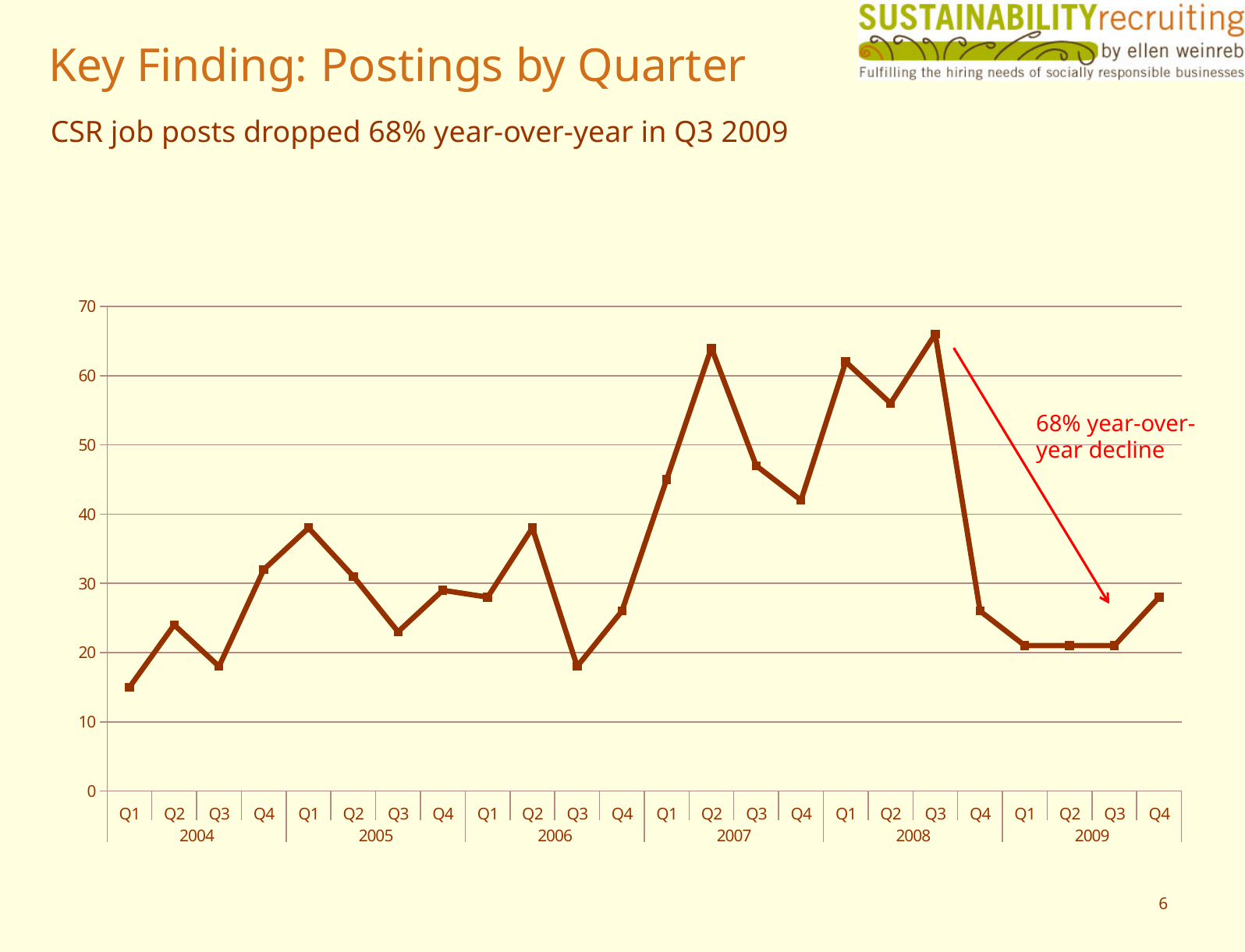
What does the red annotation on the chart say? 68% year-over-year decline Is the value for Q1 2004 greater or less than 20? less How many years are shown along the x axis of the chart? 6 Do the values rise or fall from Q3 2008 to Q4 2008? fall How many quarterly data points are plotted on the chart? 24 What kind of chart is shown on the slide? line chart Which is larger, the value for Q3 2008 or the value for Q3 2009? Q3 2008 Is the value for Q1 2005 greater or less than 30? greater Is the value for Q3 2009 greater or less than 30? less Which is larger, the value for Q2 2007 or the value for Q4 2007? Q2 2007